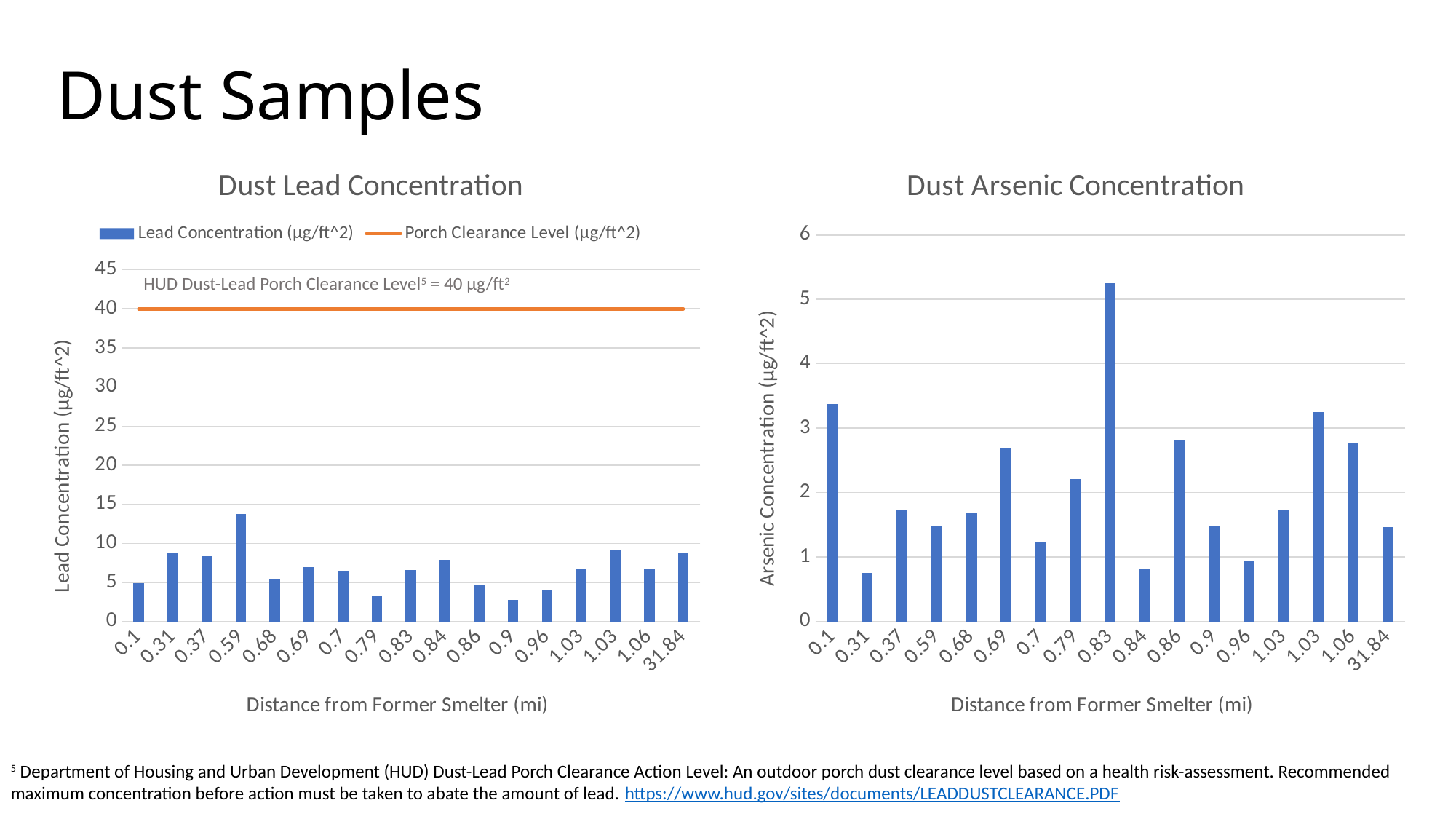
In the Dust Lead Concentration chart, which distance has the lowest lead concentration? 0.9 In the Dust Lead Concentration chart, what is the Porch Clearance Level shown by the orange line? 40 µg/ft² In the Dust Arsenic Concentration chart, which distance has the highest arsenic concentration? 0.83 In the Dust Lead Concentration chart, is the lead concentration at 0.59 mi greater or less than 10? greater In the Dust Arsenic Concentration chart, is the arsenic concentration at 0.83 mi greater or less than 5? greater What is the x-axis title of the Dust Arsenic Concentration chart? Distance from Former Smelter (mi) What kind of chart is the Dust Arsenic Concentration chart? bar chart In the Dust Arsenic Concentration chart, which distance has the lowest arsenic concentration? 0.31 In the Dust Lead Concentration chart, which distance has the highest lead concentration? 0.59 In the Dust Lead Concentration chart, how many series does the legend list? 2 In the Dust Lead Concentration chart, how many distance categories are plotted on the x axis? 17 In the Dust Arsenic Concentration chart, which has the larger arsenic concentration, 0.1 mi or 0.31 mi? 0.1